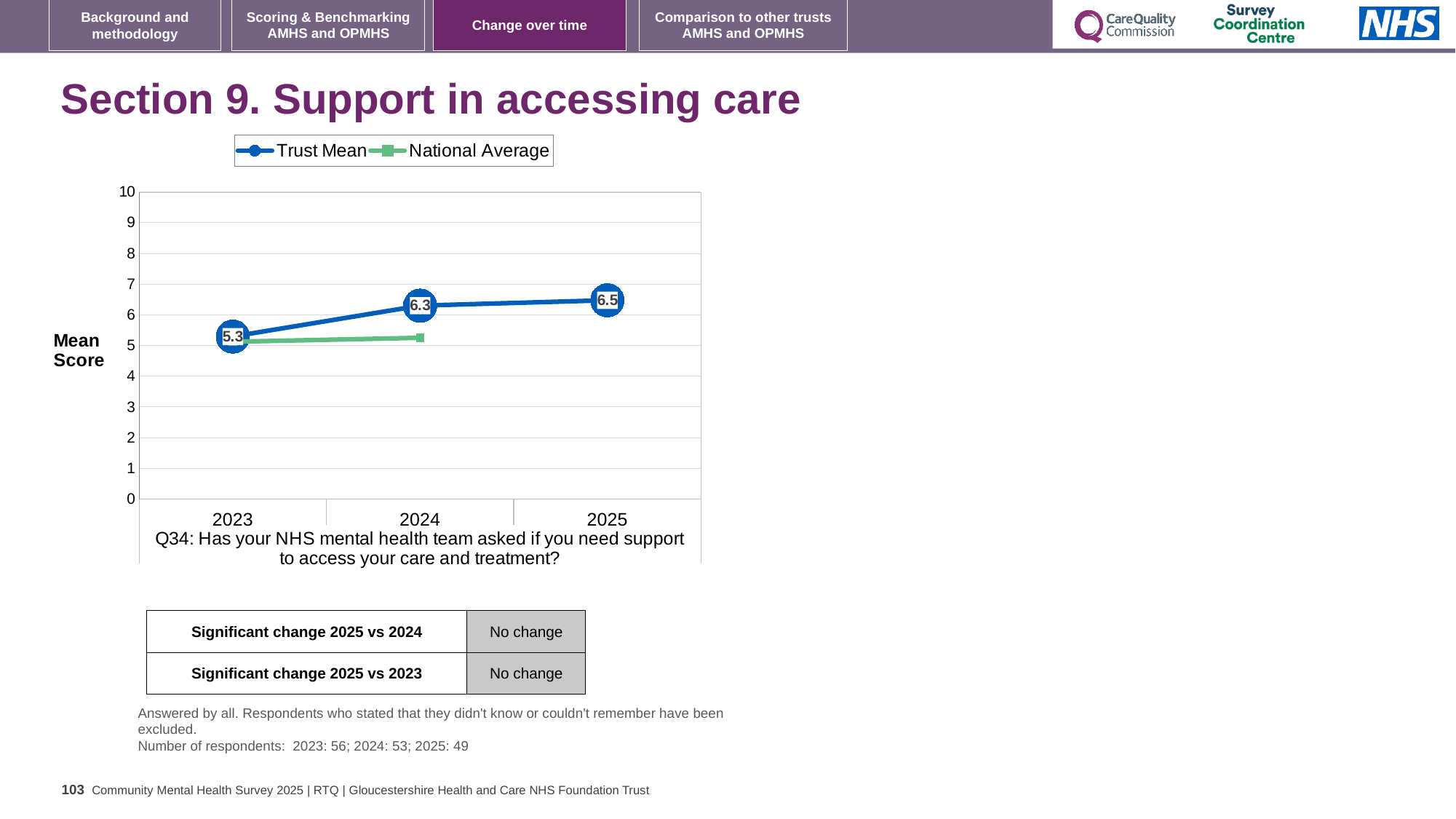
Which is larger, the Trust Mean score in 2024 or in 2025? 2025 In which year is the Trust Mean score highest? 2025 Is the National Average value for 2024 greater or less than 6? less How many years are shown on the x axis of the chart? 3 What is the Trust Mean score for 2023? 5.3 In which year is the Trust Mean score lowest? 2023 What kind of chart is shown on the slide? Line chart How many series does the chart legend list? 2 What is the Trust Mean score for 2024? 6.3 What is the difference between the Trust Mean score in 2025 and in 2023? 1.2 What is the difference between the Trust Mean score in 2024 and in 2023? 1.0 What is the Trust Mean score for 2025? 6.5